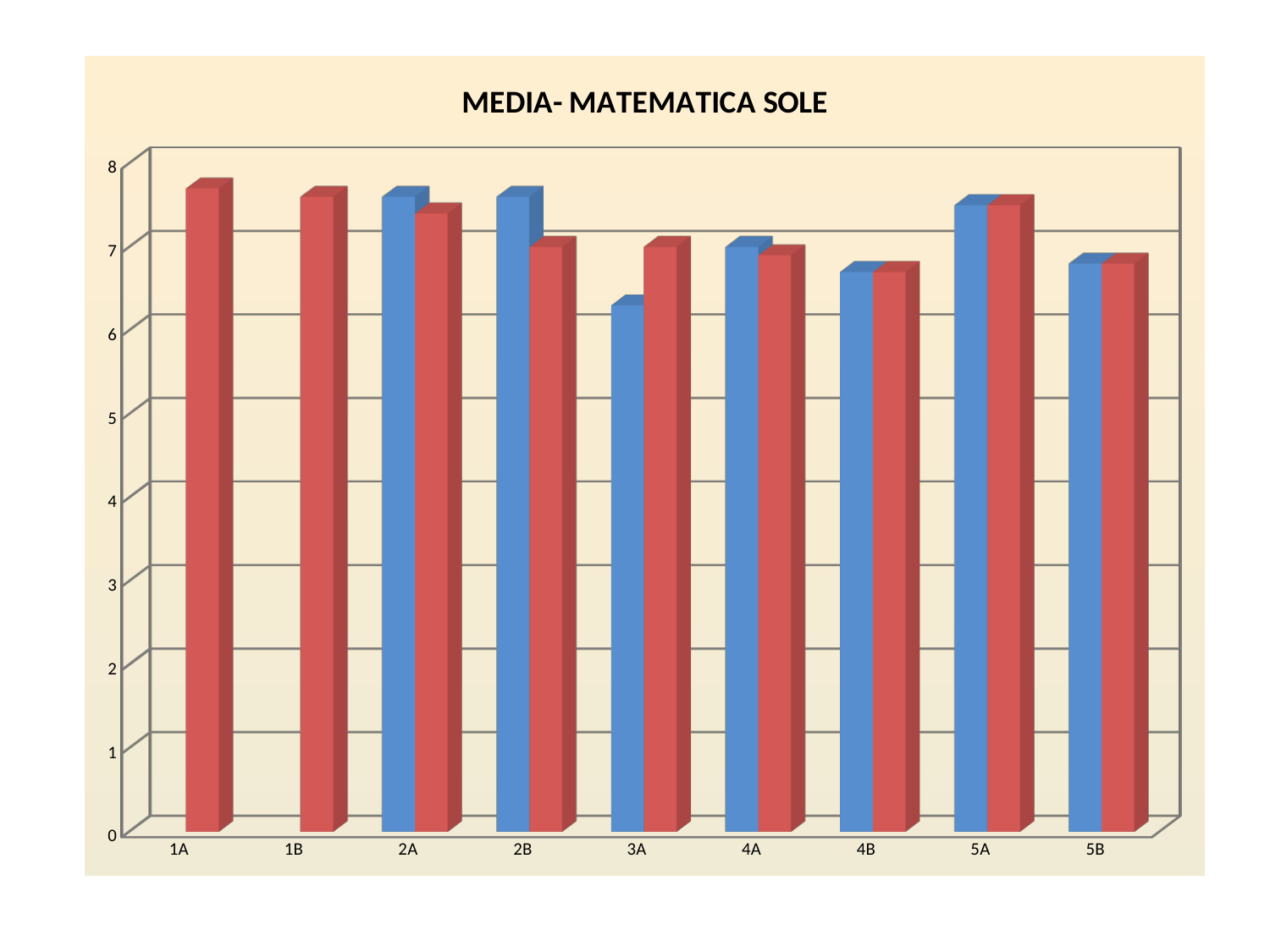
Is the blue bar for 3A greater or less than 7? less Is the blue bar for 5A greater or less than 7? greater Is the blue bar for 4B greater or less than 7? less Which category has the lowest blue bar? 3A What kind of chart is shown on the slide? bar chart Which categories have only a red bar and no blue bar? 1A and 1B How many categories are shown on the x axis of the chart? 9 For category 3A, which bar is taller, the blue one or the red one? red What is the title of the chart? MEDIA- MATEMATICA SOLE For category 2B, which bar is taller, the blue one or the red one? blue